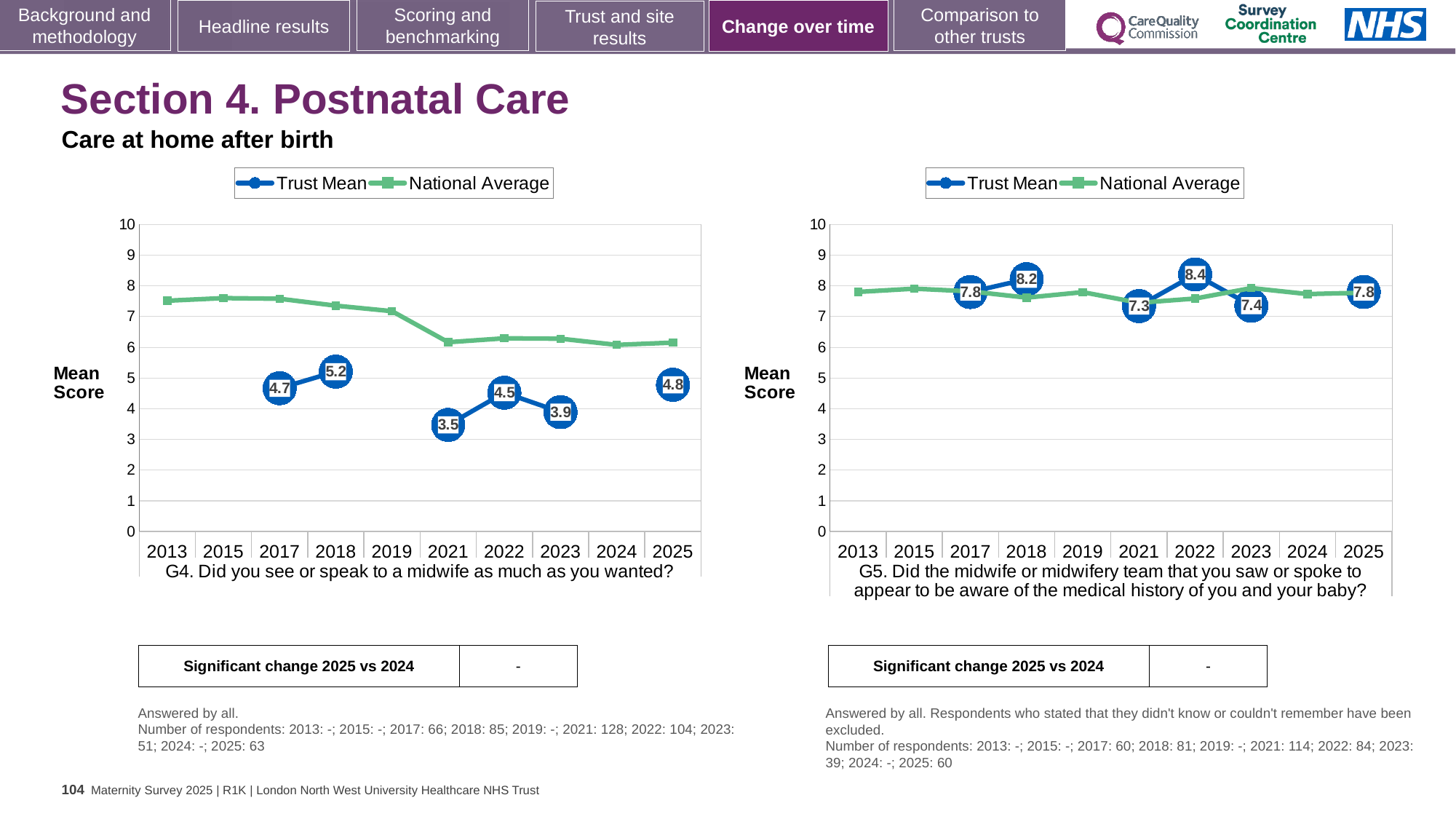
In the G5 chart (right), what is the difference between the Trust Mean for 2022 and 2021? 1.1 In the G4 chart (left), what is the Trust Mean for 2021? 3.5 In the G4 chart (left), which year has the highest Trust Mean? 2018 In the G4 chart (left), what is the difference between the Trust Mean for 2018 and 2017? 0.5 In the G5 chart (right), which year has the lowest Trust Mean? 2021 In the G4 chart (left), is the National Average for 2013 greater or less than 7? greater In the G5 chart (right), which is larger, the Trust Mean for 2018 or for 2023? 2018 What kind of chart is the G4 chart (left)? Line chart How many series does the legend of the G5 chart (right) list? 2 In the G5 chart (right), what is the Trust Mean for 2022? 8.4 In the G4 chart (left), what is the Trust Mean for 2025? 4.8 In the G4 chart (left), which year has the lowest Trust Mean? 2021